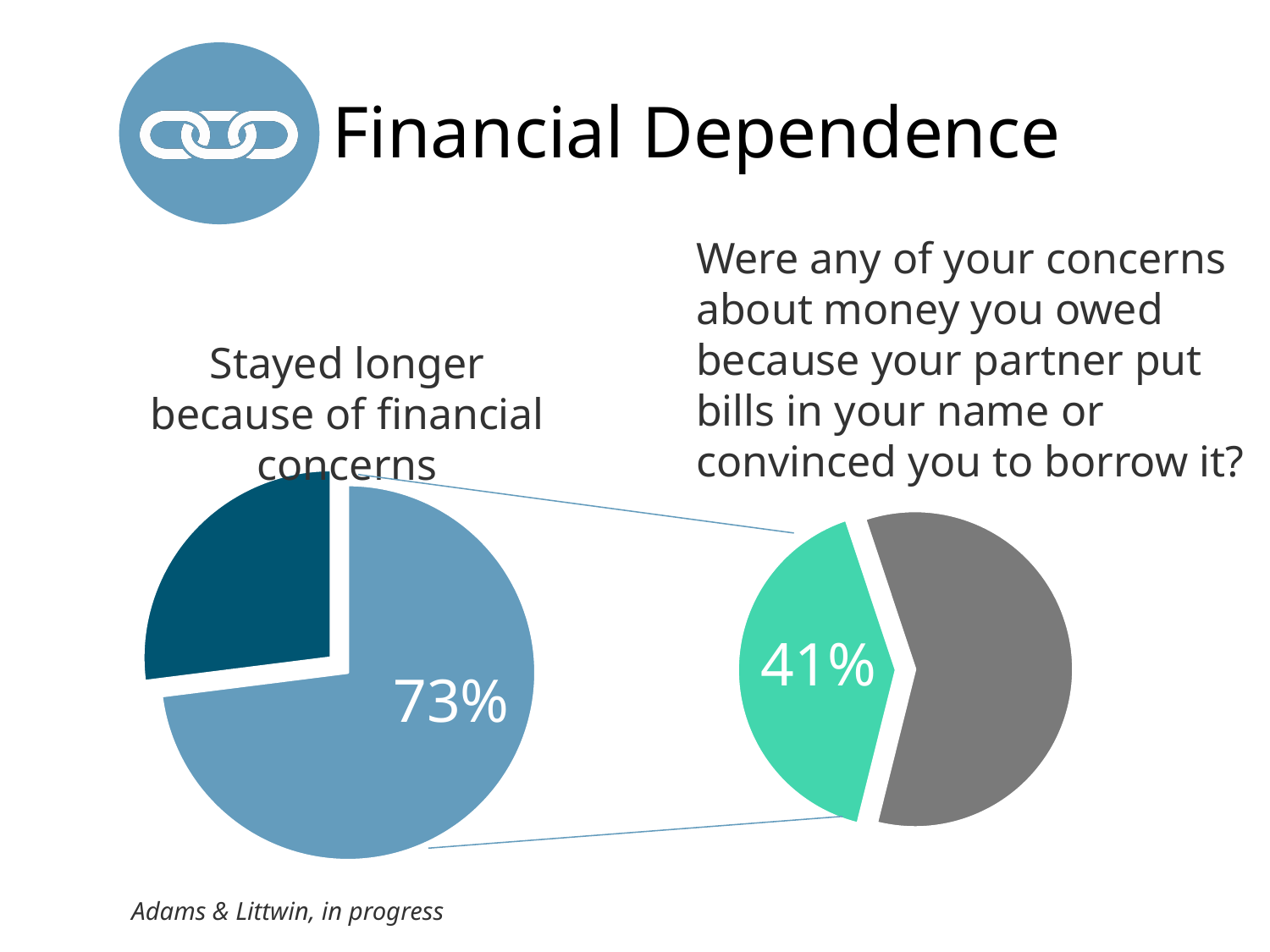
In the 'Stayed longer because of financial concerns' chart, what share of the pie does the labelled blue slice represent? 73% What colour is the slice labelled 41% in the chart on the right? green In the chart on the right, which slice is larger, the green one or the grey one? the grey one What is the title of the slide containing the two pie charts? Financial Dependence What kind of chart is the 'Stayed longer because of financial concerns' chart? pie chart How many slices does the 'Stayed longer because of financial concerns' pie chart have? 2 In the 'Stayed longer because of financial concerns' chart, which slice is larger, the light blue one or the dark blue one? the light blue one In the chart on the right, what share of the pie does the labelled green slice represent? 41% In the chart on the right about concerns over money owed, what percentage is printed on the green slice? 41% What kind of chart is the chart on the right of the slide? pie chart In the 'Stayed longer because of financial concerns' chart, what percentage is printed on the large blue slice? 73% How many slices does the pie chart on the right of the slide have? 2